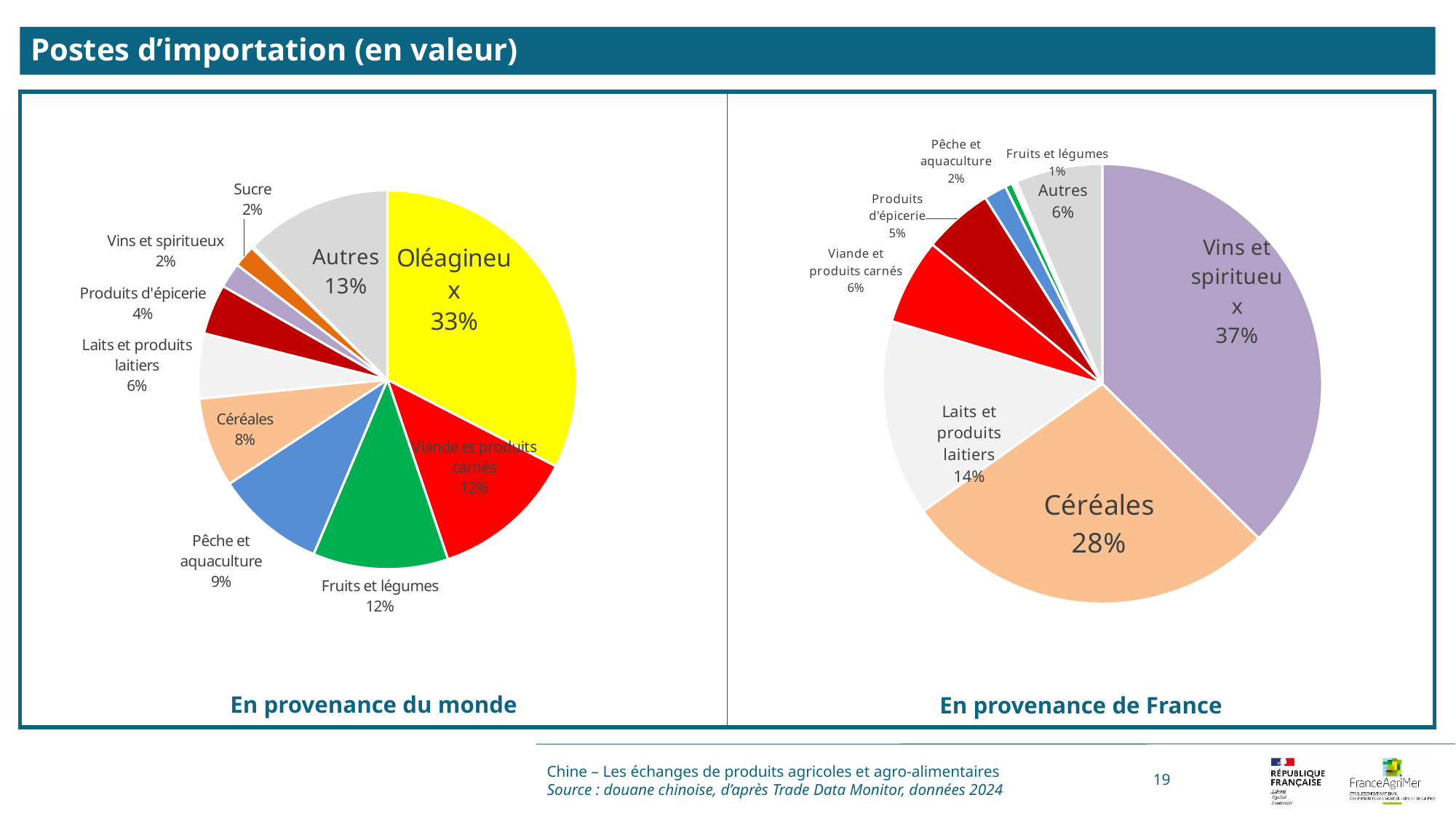
In the 'En provenance du monde' chart, what share is Oléagineux? 33% How many categories are shown in the 'En provenance du monde' chart? 10 What type of chart is used for 'En provenance de France'? Pie chart How many categories are shown in the 'En provenance de France' chart? 8 In the 'En provenance du monde' chart, which is larger: Pêche et aquaculture or Céréales? Pêche et aquaculture In the 'En provenance de France' chart, which category has the smallest share? Fruits et légumes In the 'En provenance de France' chart, what share is Céréales? 28% In the 'En provenance du monde' chart, what is the difference between the shares of Oléagineux and Autres? 20 percentage points In the 'En provenance de France' chart, what is the difference between the shares of Vins et spiritueux and Céréales? 9 percentage points In the 'En provenance de France' chart, what share is Laits et produits laitiers? 14% In the 'En provenance de France' chart, which category has the largest share? Vins et spiritueux In the 'En provenance du monde' chart, which category has the largest share? Oléagineux